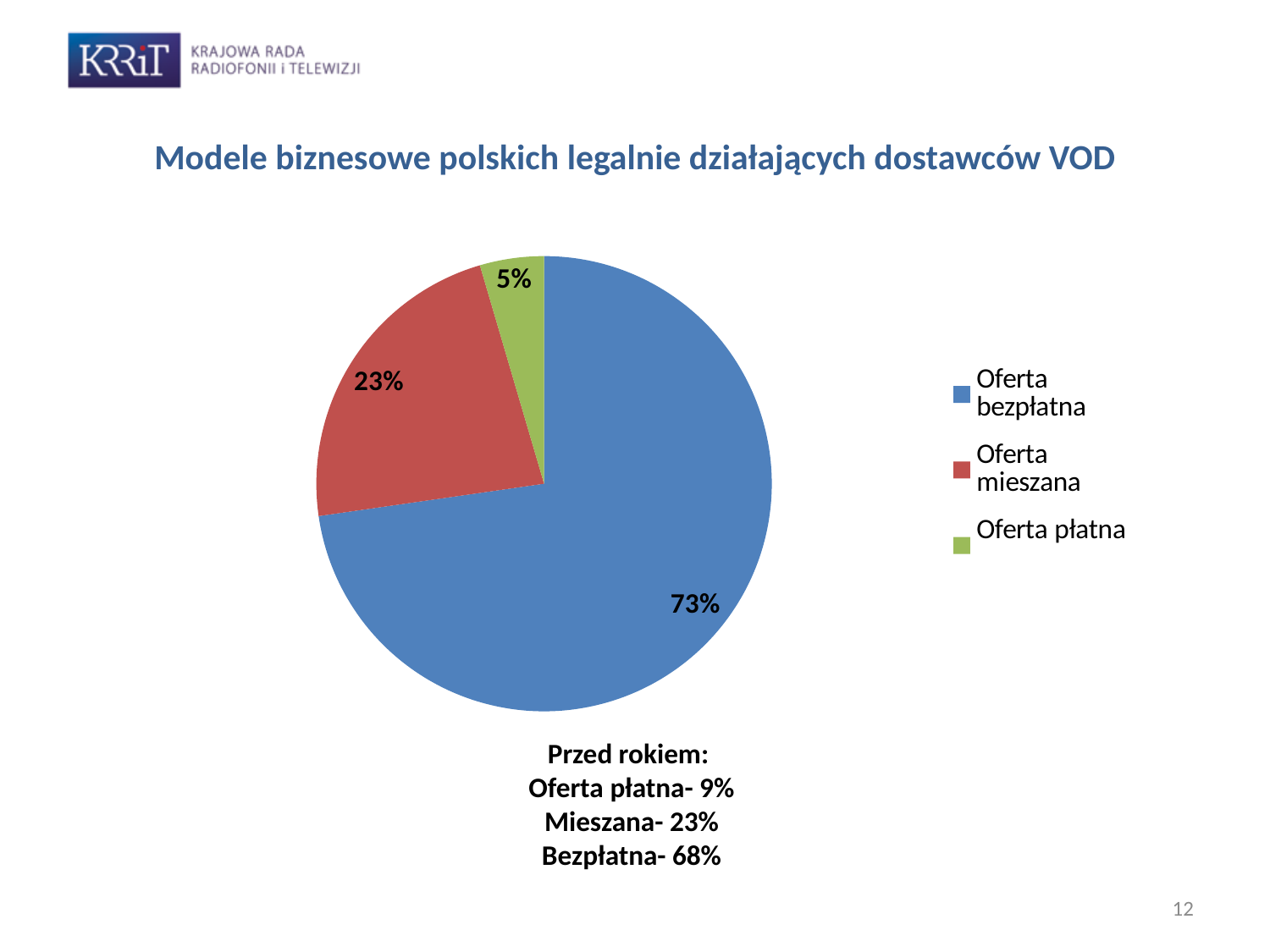
Which is larger, the slice for "Oferta mieszana" or the slice for "Oferta płatna"? Oferta mieszana How many entries does the legend list? 3 What share of the pie does "Oferta mieszana" have? 23% What kind of chart is shown on the slide? pie chart What is the title of the chart on the slide? Modele biznesowe polskich legalnie działających dostawców VOD Which category has the largest slice of the pie? Oferta bezpłatna How many slices does the pie chart have? 3 What is the difference in percentage points between "Oferta mieszana" and "Oferta płatna"? 18 Which category has the smallest slice of the pie? Oferta płatna What share of the pie does "Oferta płatna" have? 5% What share of the pie does "Oferta bezpłatna" have? 73% What is the difference in percentage points between "Oferta bezpłatna" and "Oferta mieszana"? 50